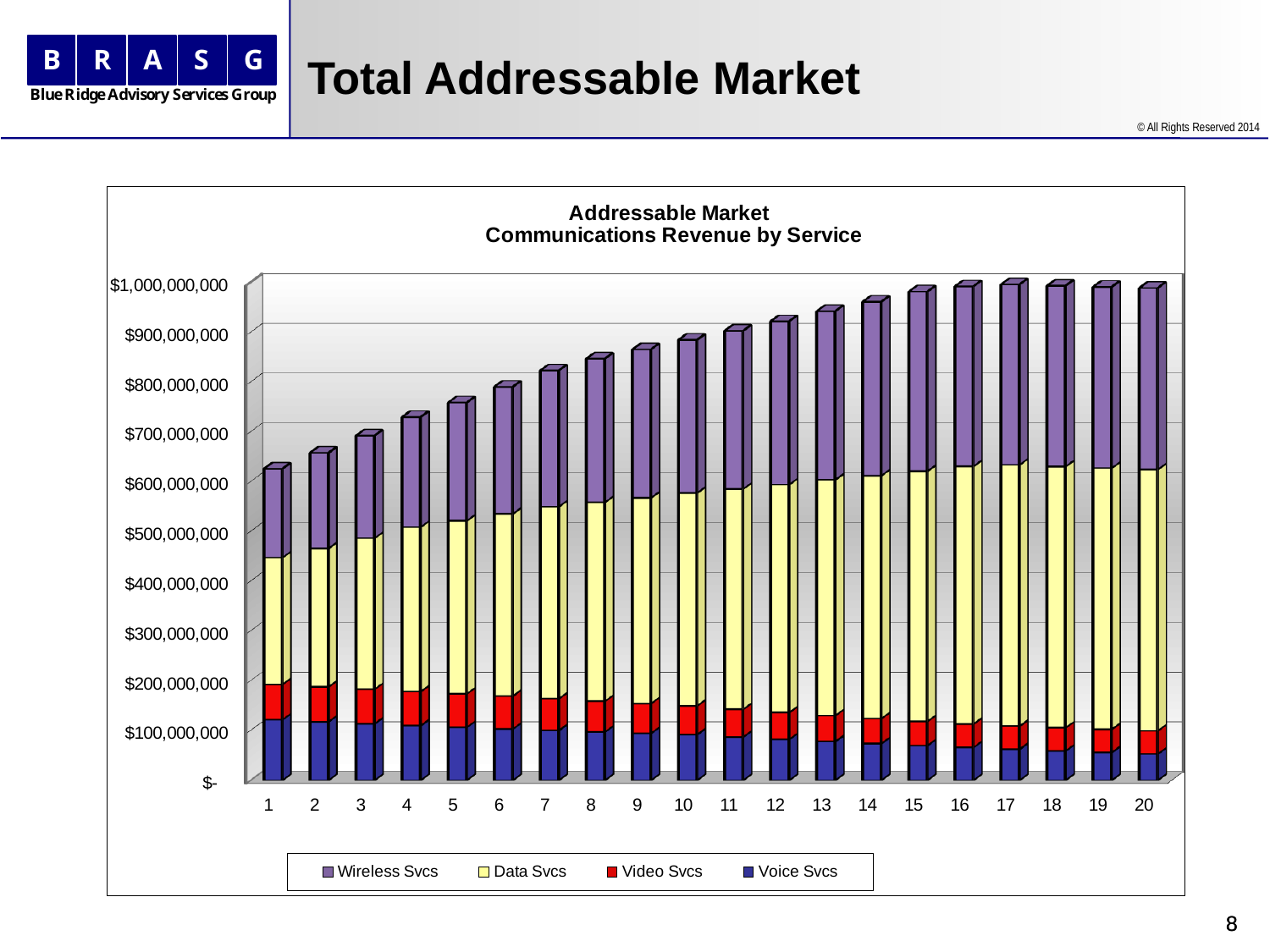
Do the total bar heights rise or fall from period 1 to period 20? rise Which has the larger total, period 1 or period 10? period 10 Does the Voice Svcs segment get larger or smaller from period 1 to period 20? smaller Is the total for period 20 greater or less than $900,000,000? greater Is the total for period 1 greater or less than $700,000,000? less Which period has the lowest total bar? 1 How many series does the legend list? 4 Is the Voice Svcs value for period 20 greater or less than $100,000,000? less What kind of chart is shown on the slide? stacked bar chart How many bars (periods) are plotted along the x axis? 20 Which series is shown in yellow in the legend? Data Svcs What is the title of the chart? Addressable Market Communications Revenue by Service